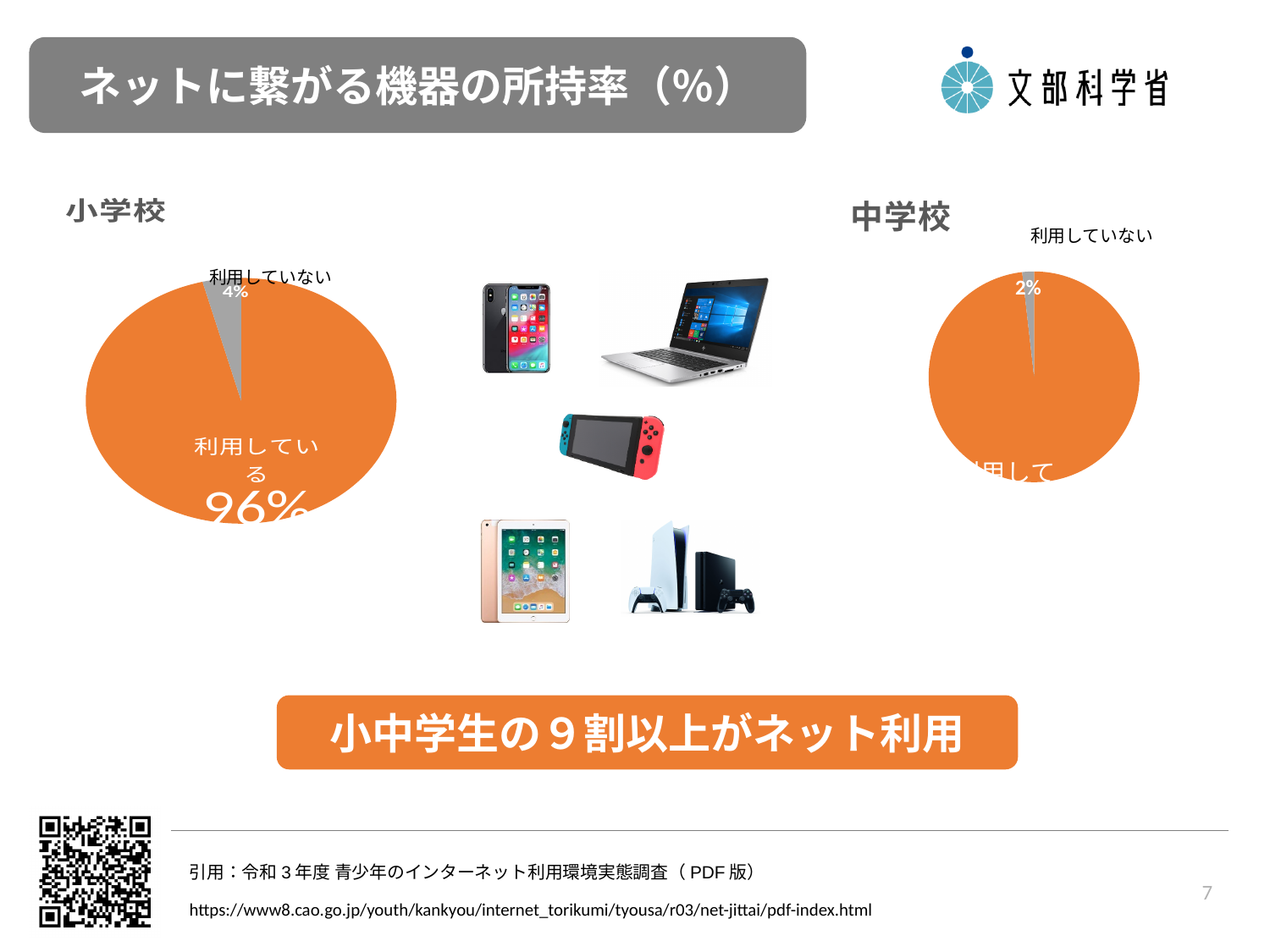
What kind of chart is used for the 小学校 data? Pie chart What colour is the 利用している slice in the 小学校 pie chart? Orange In the 小学校 pie chart, which category has the smallest share? 利用していない Which chart shows a larger value for 利用していない, the 小学校 chart or the 中学校 chart? 小学校 In the 小学校 pie chart, what is the value for 利用している? 96% What is the title shown at the top of the slide? ネットに繋がる機器の所持率（%） In the 小学校 pie chart, what is the difference between 利用している and 利用していない? 92 percentage points In the 小学校 pie chart, what is the value for 利用していない? 4% In the 中学校 pie chart, which category has the smallest share? 利用していない In the 小学校 pie chart, which category has the largest share? 利用している In the 中学校 pie chart, what is the value for 利用していない? 2% How many slices does the 小学校 pie chart have? 2